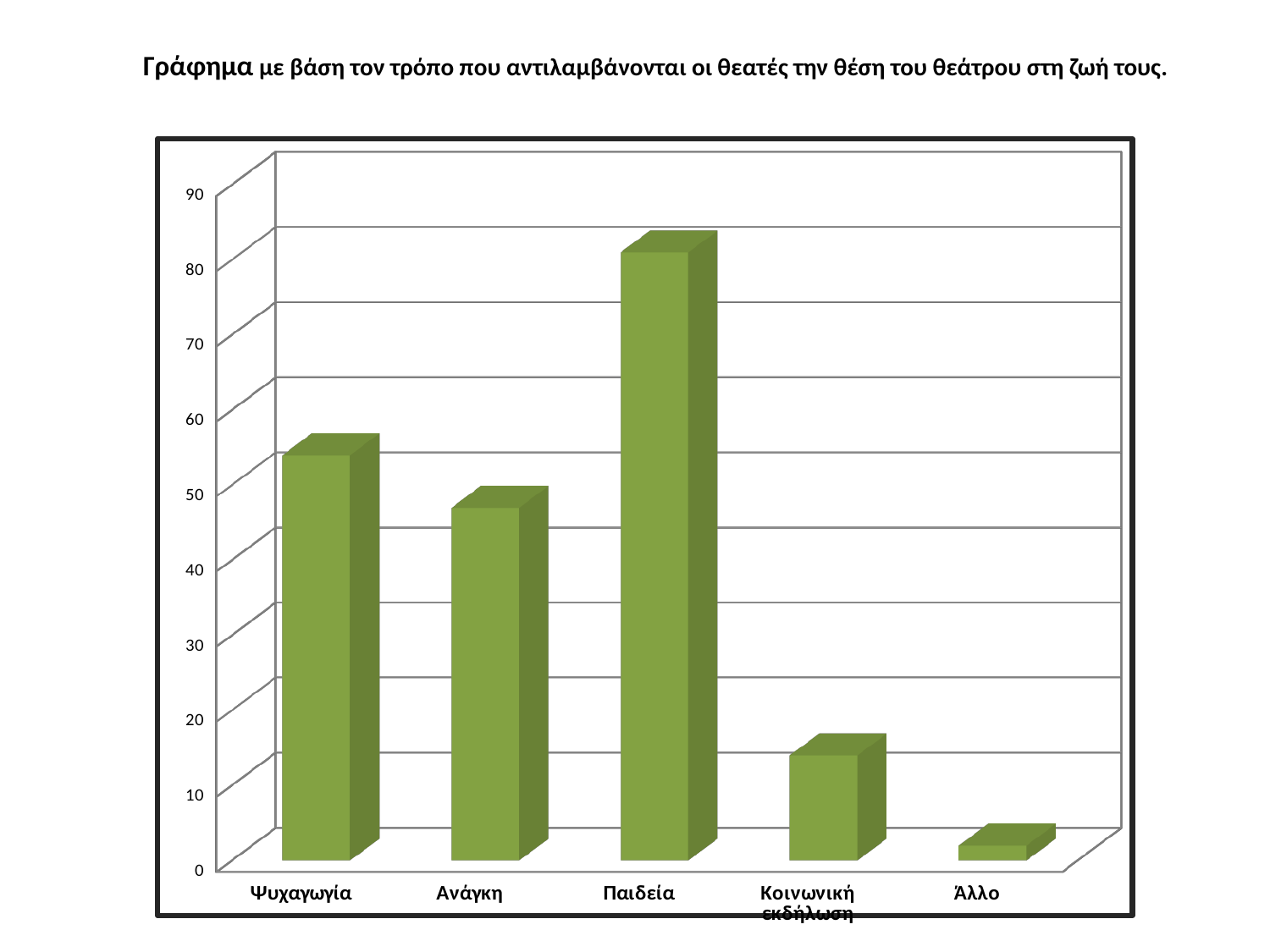
Is the value for Ψυχαγωγία greater or less than 50? greater Which is larger, the value for Ψυχαγωγία or the value for Ανάγκη? Ψυχαγωγία How many categories are shown on the x axis of the chart? 5 Is the value for Παιδεία greater or less than 70? greater Is the value for Άλλο greater or less than 10? less What kind of chart is shown on the slide? bar chart What colour are the bars in the chart? green Which is larger, the value for Κοινωνική εκδήλωση or the value for Παιδεία? Παιδεία Which category has the lowest bar in the chart? Άλλο Which category has the highest bar in the chart? Παιδεία